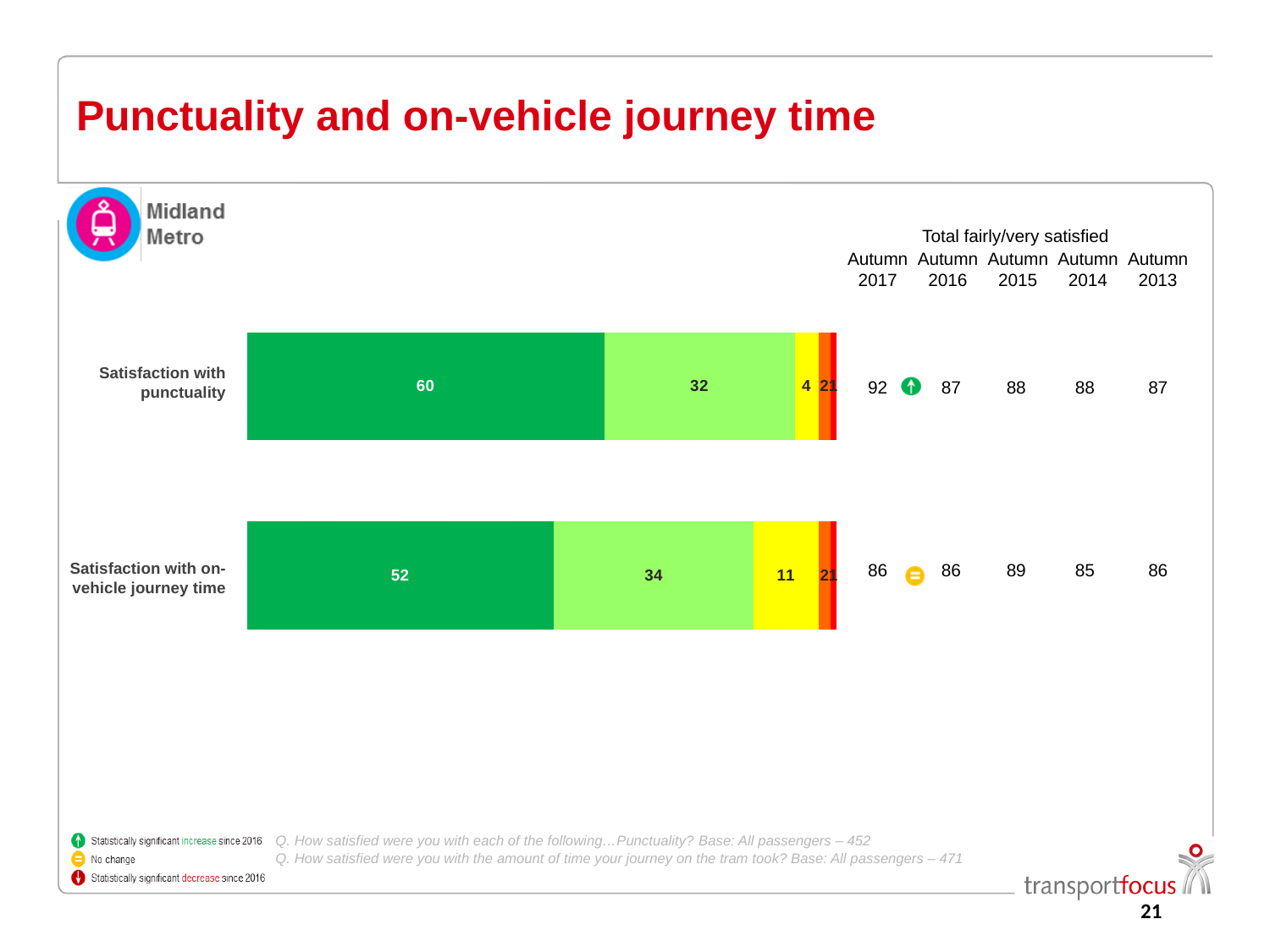
What is the value of the yellow segment for Satisfaction with punctuality? 4 Which category has the higher Total fairly/very satisfied value in Autumn 2017? Satisfaction with punctuality What is the Total fairly/very satisfied value for Satisfaction with on-vehicle journey time in Autumn 2015? 89 What is the difference between the dark green segment values for Satisfaction with punctuality and Satisfaction with on-vehicle journey time? 8 What is the value of the dark green segment for Satisfaction with punctuality? 60 What is the value of the dark green segment for Satisfaction with on-vehicle journey time? 52 What type of chart is shown on the slide? stacked bar chart What is the Total fairly/very satisfied value for Satisfaction with punctuality in Autumn 2017? 92 Which category has the larger dark green segment, Satisfaction with punctuality or Satisfaction with on-vehicle journey time? Satisfaction with punctuality What is the value of the yellow segment for Satisfaction with on-vehicle journey time? 11 What is the value of the light green segment for Satisfaction with on-vehicle journey time? 34 How many categories (bars) does the chart show? 2